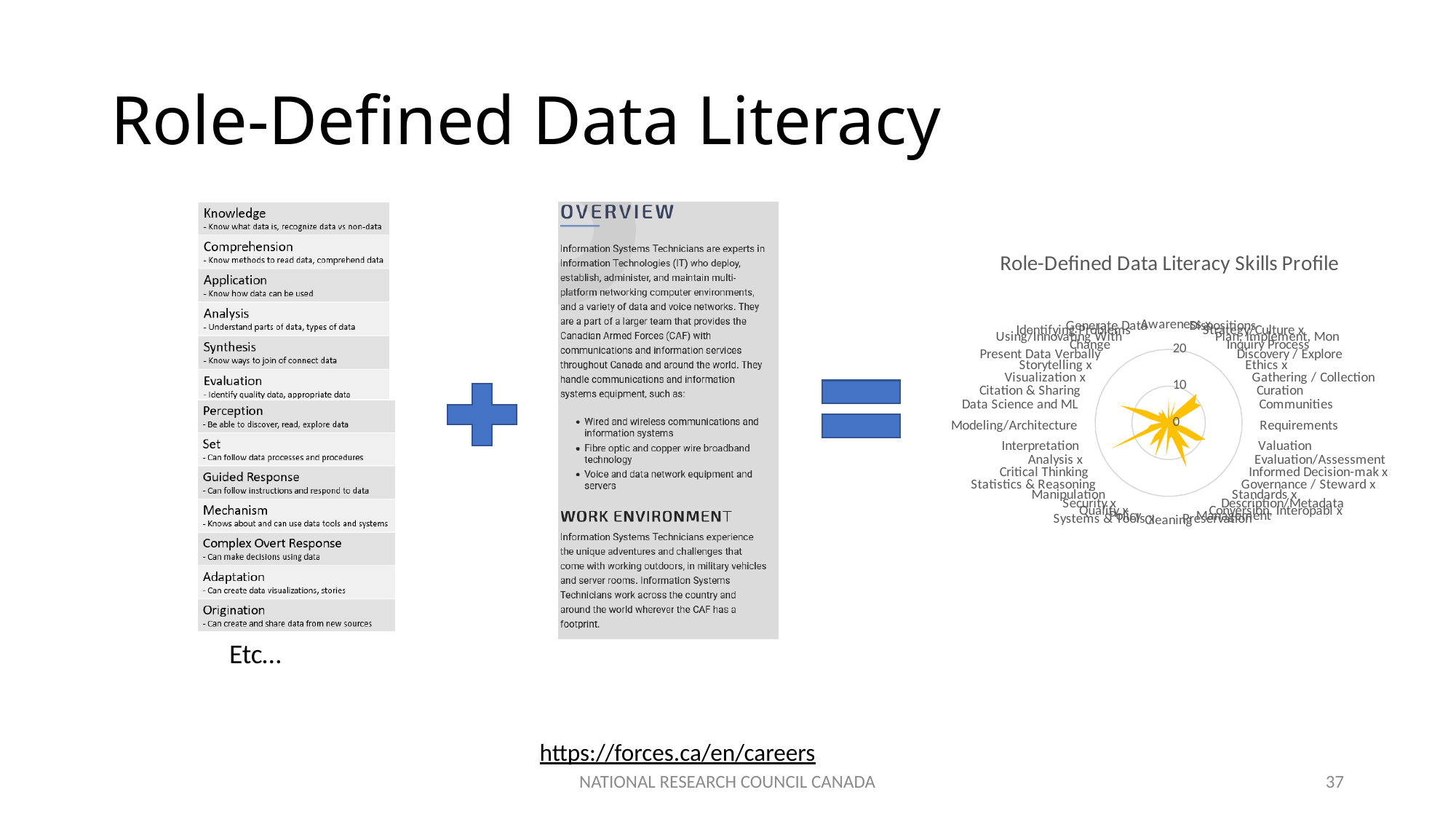
What kind of chart is the Role-Defined Data Literacy Skills Profile chart? radar chart In the Role-Defined Data Literacy Skills Profile chart, is the value for Requirements greater or less than 10? less In the Role-Defined Data Literacy Skills Profile chart, what is the highest value labelled on the radial axis? 20 In the Role-Defined Data Literacy Skills Profile chart, is the value for Modeling/Architecture greater or less than 20? less In the Role-Defined Data Literacy Skills Profile chart, is the value for Gathering / Collection greater or less than 20? less What is the title of the chart on the right side of the slide? Role-Defined Data Literacy Skills Profile